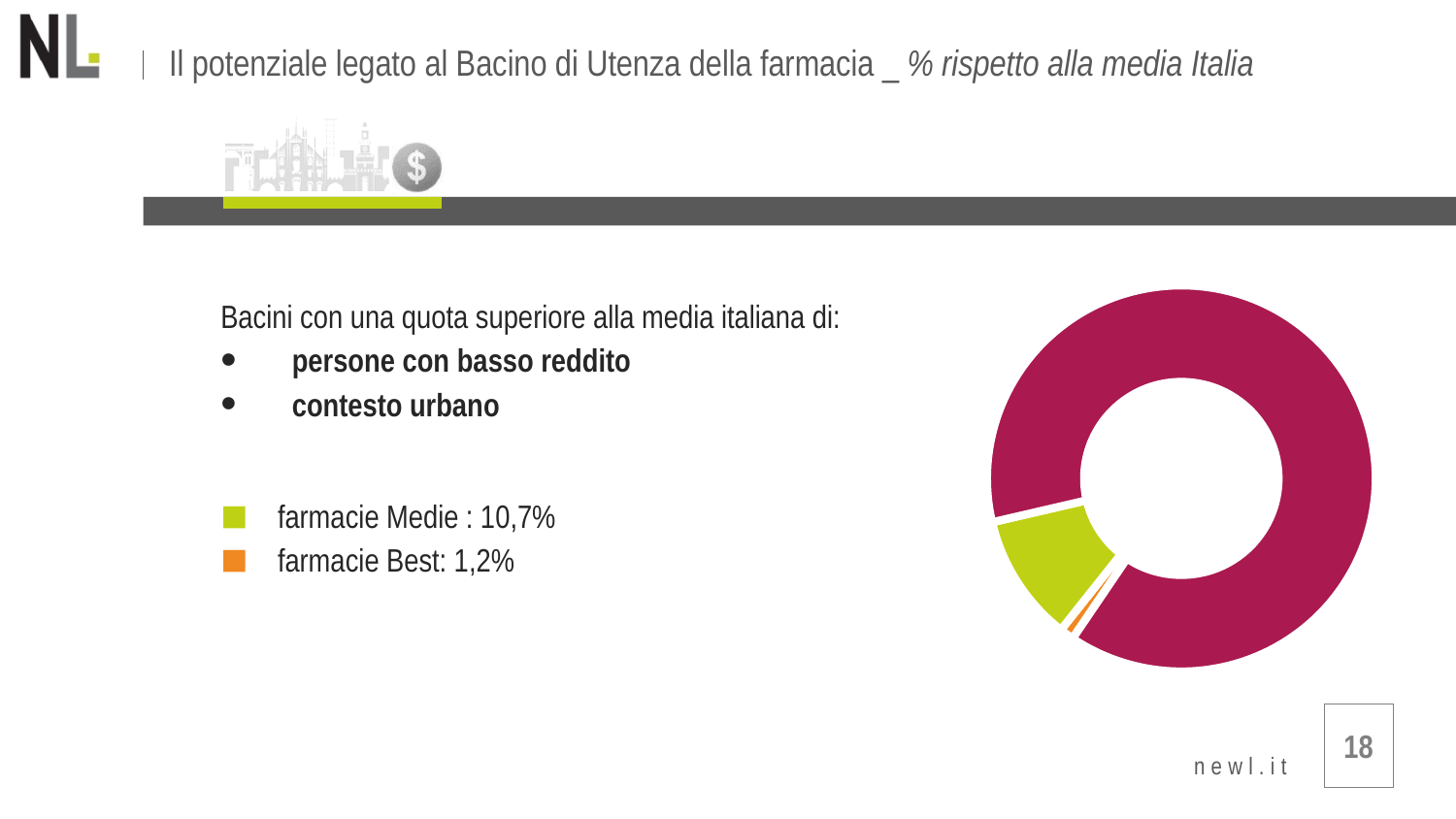
What is the difference between the values for farmacie Medie and farmacie Best? 9,5% What is the value shown for farmacie Best? 1,2% What is the value shown for farmacie Medie? 10,7% What colour represents farmacie Best in the chart? Orange Of the two labelled categories, which has the larger value? farmacie Medie What is the combined value of farmacie Medie and farmacie Best? 11,9% Which is larger, farmacie Medie or farmacie Best? farmacie Medie Of the two labelled categories, which has the smaller value? farmacie Best How many slices does the donut chart have? 3 How many entries does the legend list? 2 What kind of chart is shown on the slide? Pie chart (donut) What colour represents farmacie Medie in the chart? Green